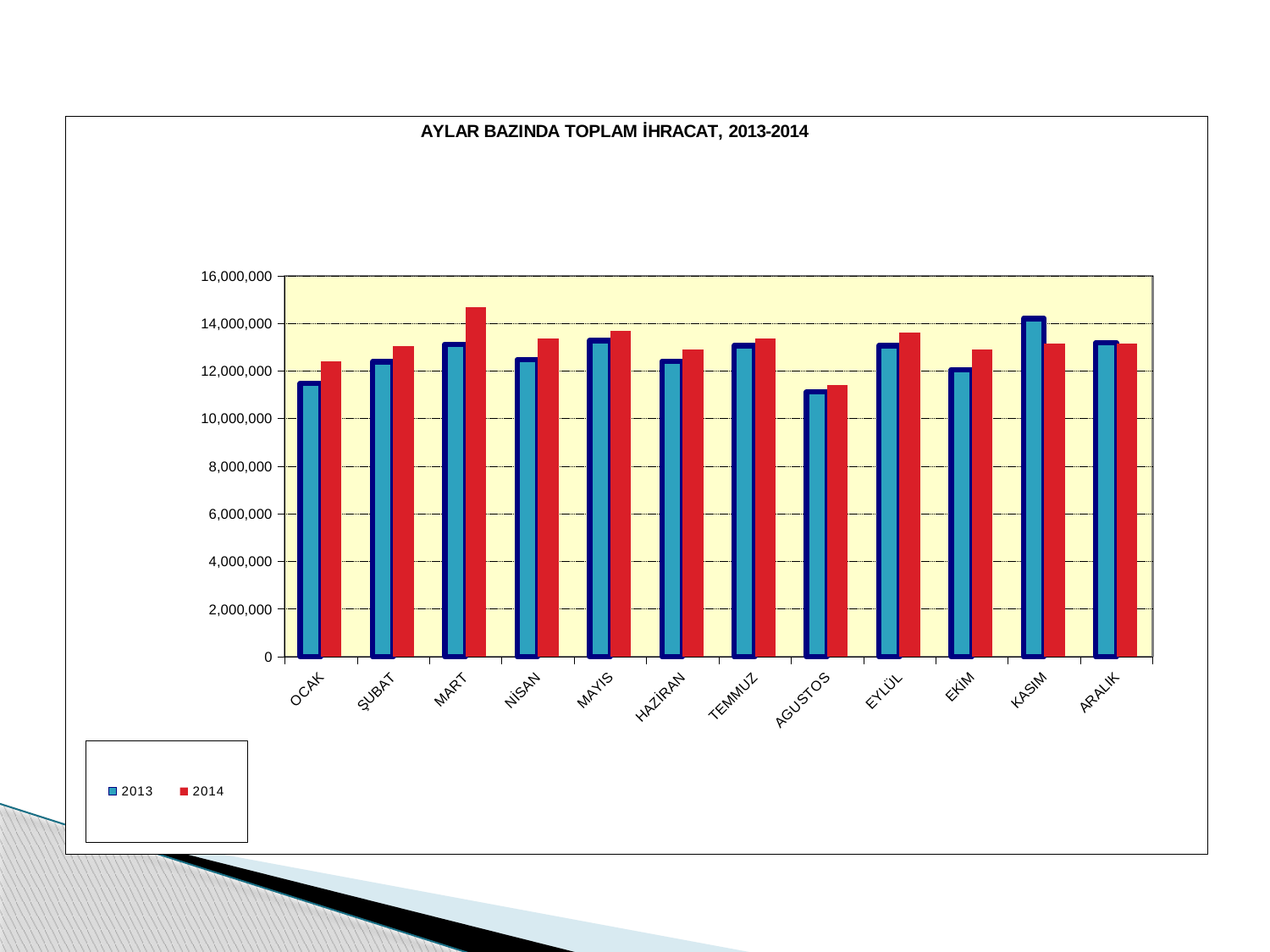
Which month has the highest value for the 2014 series? MART Which month has the lowest value for the 2013 series? AGUSTOS What kind of chart is shown on the slide? bar chart How many months (categories) are shown on the x axis? 12 What is the title of the chart? AYLAR BAZINDA TOPLAM İHRACAT, 2013-2014 Which month has the highest value for the 2013 series? KASIM For OCAK, which series has the larger value, 2013 or 2014? 2014 Which month has the lowest value for the 2014 series? AGUSTOS Is the 2014 value for MART greater or less than 14,000,000? greater How many series does the legend list? 2 Is the 2013 value for OCAK greater or less than 12,000,000? less For KASIM, which series has the larger value, 2013 or 2014? 2013